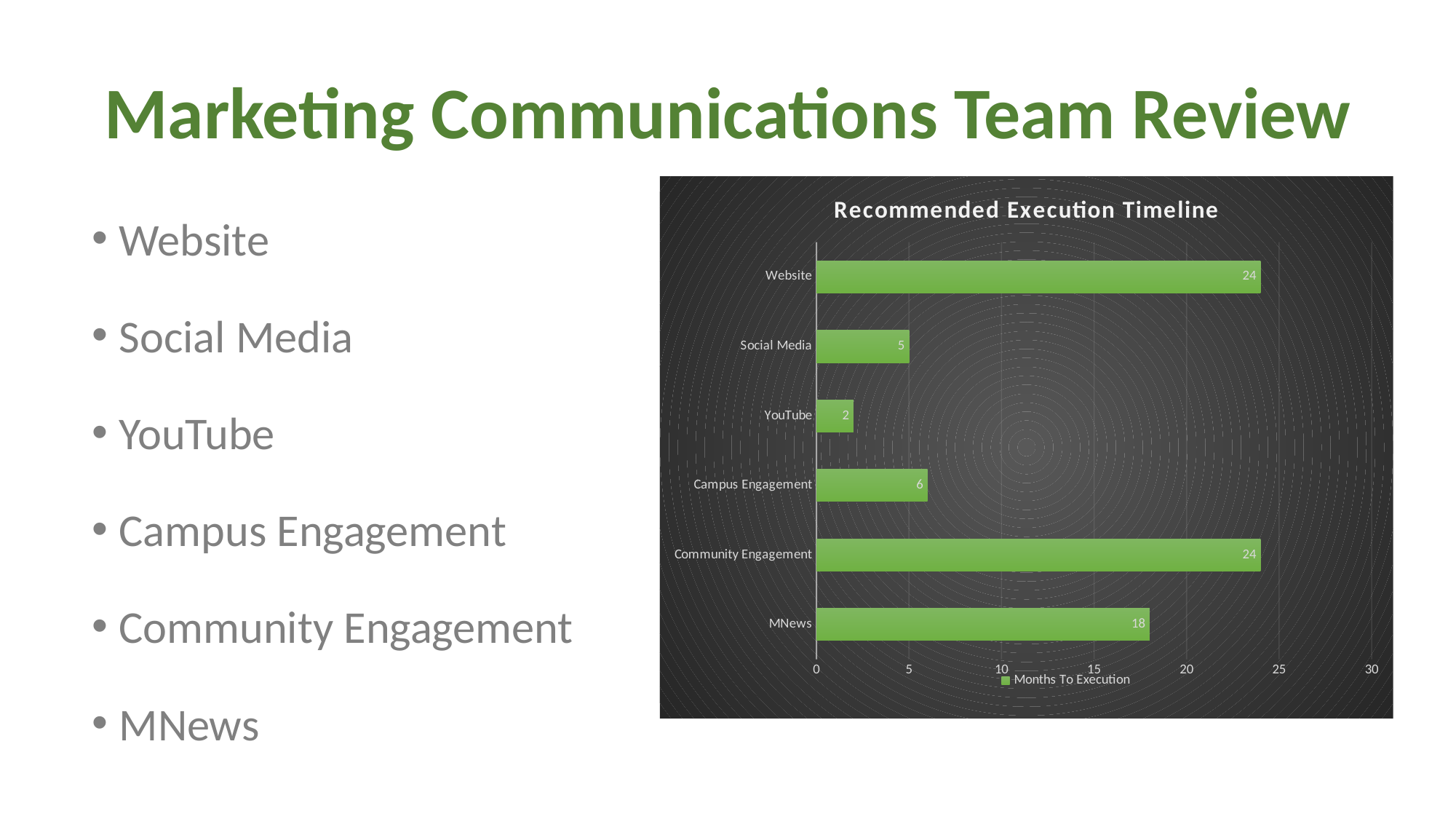
What kind of chart is the Recommended Execution Timeline chart? bar chart Is the value for Community Engagement greater or less than 20 in the Recommended Execution Timeline chart? greater How many categories are shown in the Recommended Execution Timeline chart? 6 What is the value for Website in the Recommended Execution Timeline chart? 24 What is the value for Social Media in the Recommended Execution Timeline chart? 5 What is the value for MNews in the Recommended Execution Timeline chart? 18 What is the difference between the values for Website and MNews in the Recommended Execution Timeline chart? 6 Which category has the lowest value in the Recommended Execution Timeline chart? YouTube What is the legend entry in the Recommended Execution Timeline chart? Months To Execution What is the difference between the values for Campus Engagement and YouTube in the Recommended Execution Timeline chart? 4 What is the value for YouTube in the Recommended Execution Timeline chart? 2 Which is larger in the Recommended Execution Timeline chart, Campus Engagement or Social Media? Campus Engagement